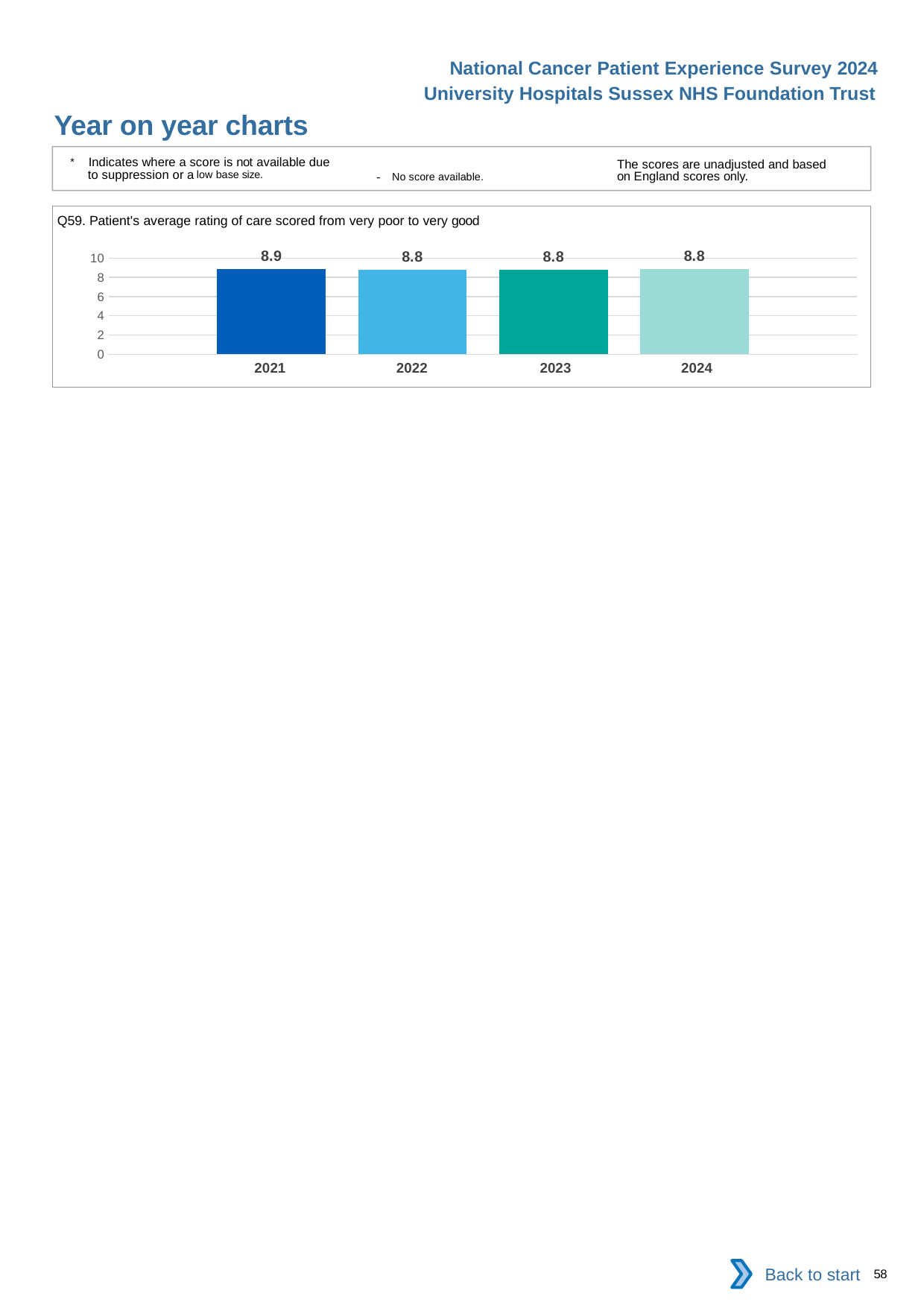
How many years are shown on the chart? 4 Do the values rise or fall from 2021 to 2022? Fall Which year has the highest value? 2021 What kind of chart is shown? Bar chart Is the value for 2023 greater or less than 6? greater What is the value for 2022? 8.8 What is the value for 2021? 8.9 Which is larger, the value for 2021 or the value for 2022? 2021 What is the difference between the values for 2021 and 2024? 0.1 What is the value for 2024? 8.8 What is the title of the chart? Q59. Patient's average rating of care scored from very poor to very good What is the value for 2023? 8.8